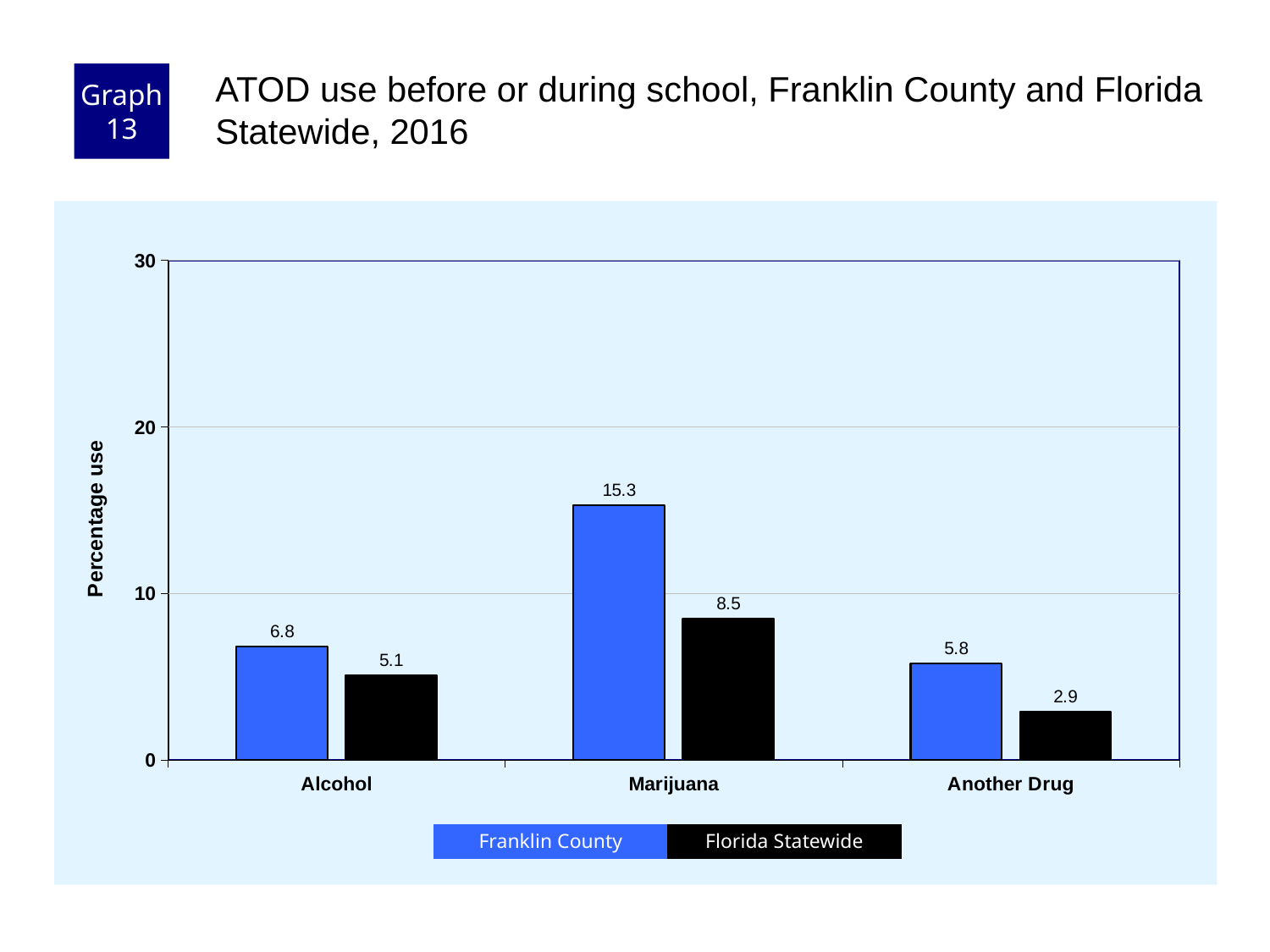
What is the Florida Statewide value for Alcohol? 5.1 What is the difference between the Franklin County values for Alcohol and Another Drug? 1.0 Is the Franklin County value for Marijuana greater or less than 10? greater Which category has the highest Franklin County value? Marijuana What is the difference between the Franklin County and Florida Statewide values for Marijuana? 6.8 Which is larger for Alcohol: the Franklin County value or the Florida Statewide value? Franklin County How many categories are shown on the x axis? 3 How many series does the legend list? 2 What is the Franklin County value for Marijuana? 15.3 Which category has the lowest Florida Statewide value? Another Drug What kind of chart is shown on the slide? bar chart What is the Florida Statewide value for Another Drug? 2.9